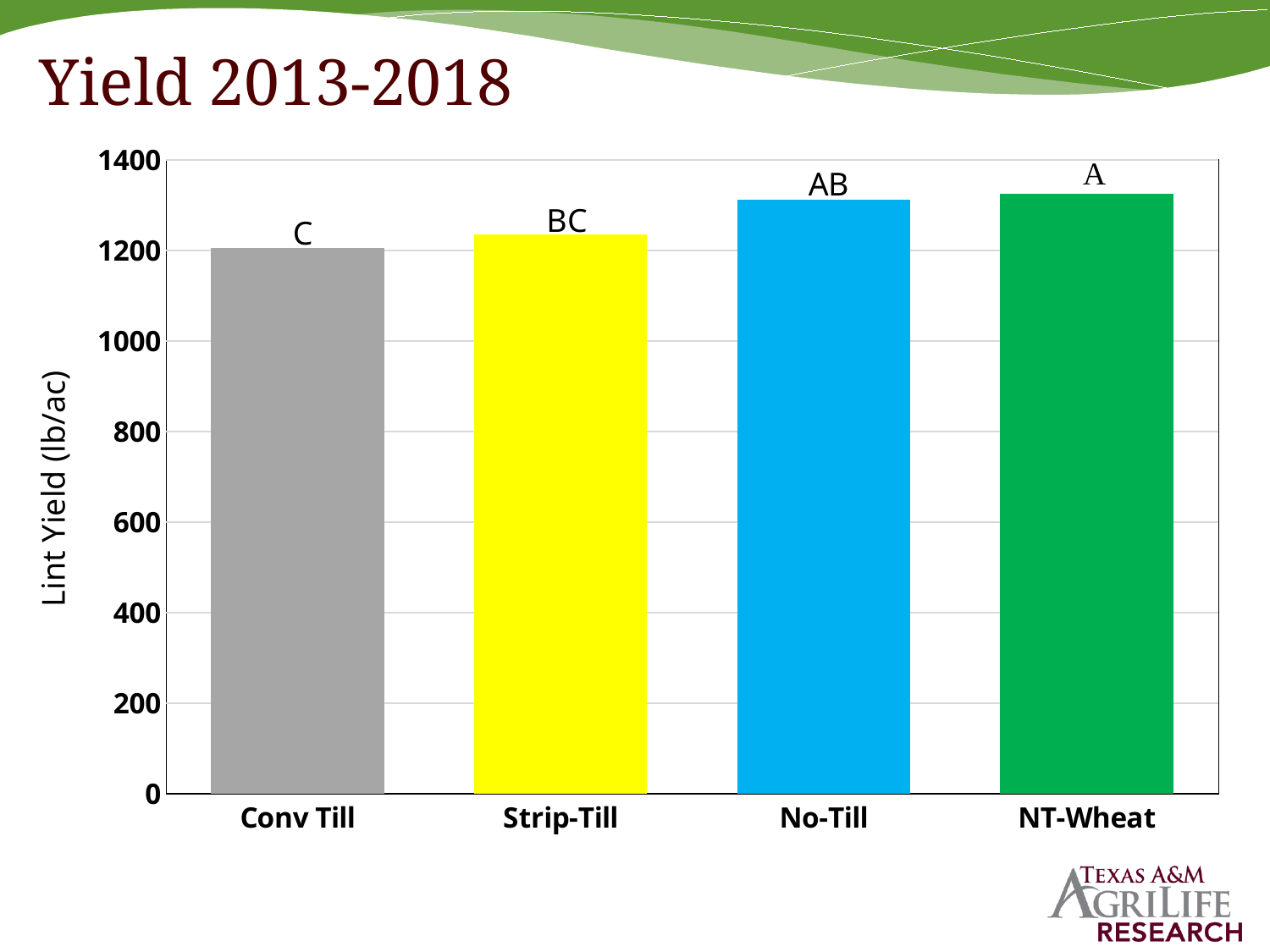
Is the value for NT-Wheat greater or less than 1400? less What letter is printed above the Conv Till bar? C Do the lint yield values rise or fall moving from Conv Till to NT-Wheat along the x axis? rise Is the value for Strip-Till greater or less than 1000? greater Which is larger, the lint yield for Conv Till or for No-Till? No-Till Is the value for No-Till greater or less than 1200? greater How many tillage categories are plotted on the x axis? 4 What is the label on the y axis of the chart? Lint Yield (lb/ac) Which is larger, the lint yield for Strip-Till or for NT-Wheat? NT-Wheat What kind of chart is shown on the slide? bar chart Which category has the lowest lint yield? Conv Till